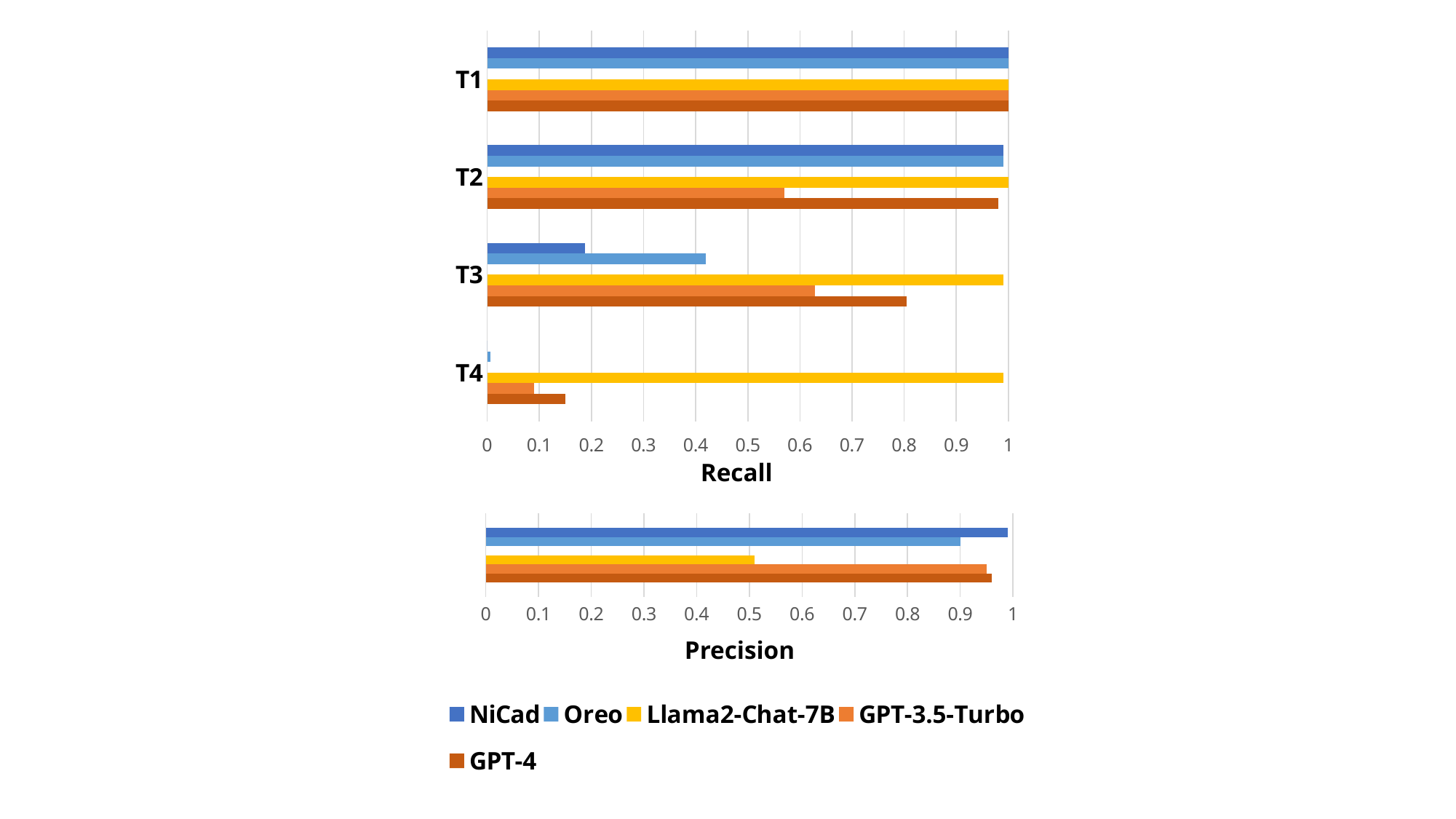
On the Recall chart, which series has the lowest value for T3? NiCad On the Recall chart, which series has the highest value for T3? Llama2-Chat-7B On the Recall chart, is the value for GPT-4 at T3 greater or less than 0.7? greater How many categories (T1–T4) are shown on the Recall chart? 4 On the Precision chart, which series has the lowest value? Llama2-Chat-7B On the Recall chart, is the value for GPT-3.5-Turbo at T2 greater or less than 0.6? less What is the axis label of the bottom chart? Precision On the Recall chart, is the value for Llama2-Chat-7B at T4 greater or less than 0.9? greater On the Recall chart, which is larger at T3: Oreo or NiCad? Oreo How many series does the legend list? 5 What kind of chart is the Recall chart? bar chart